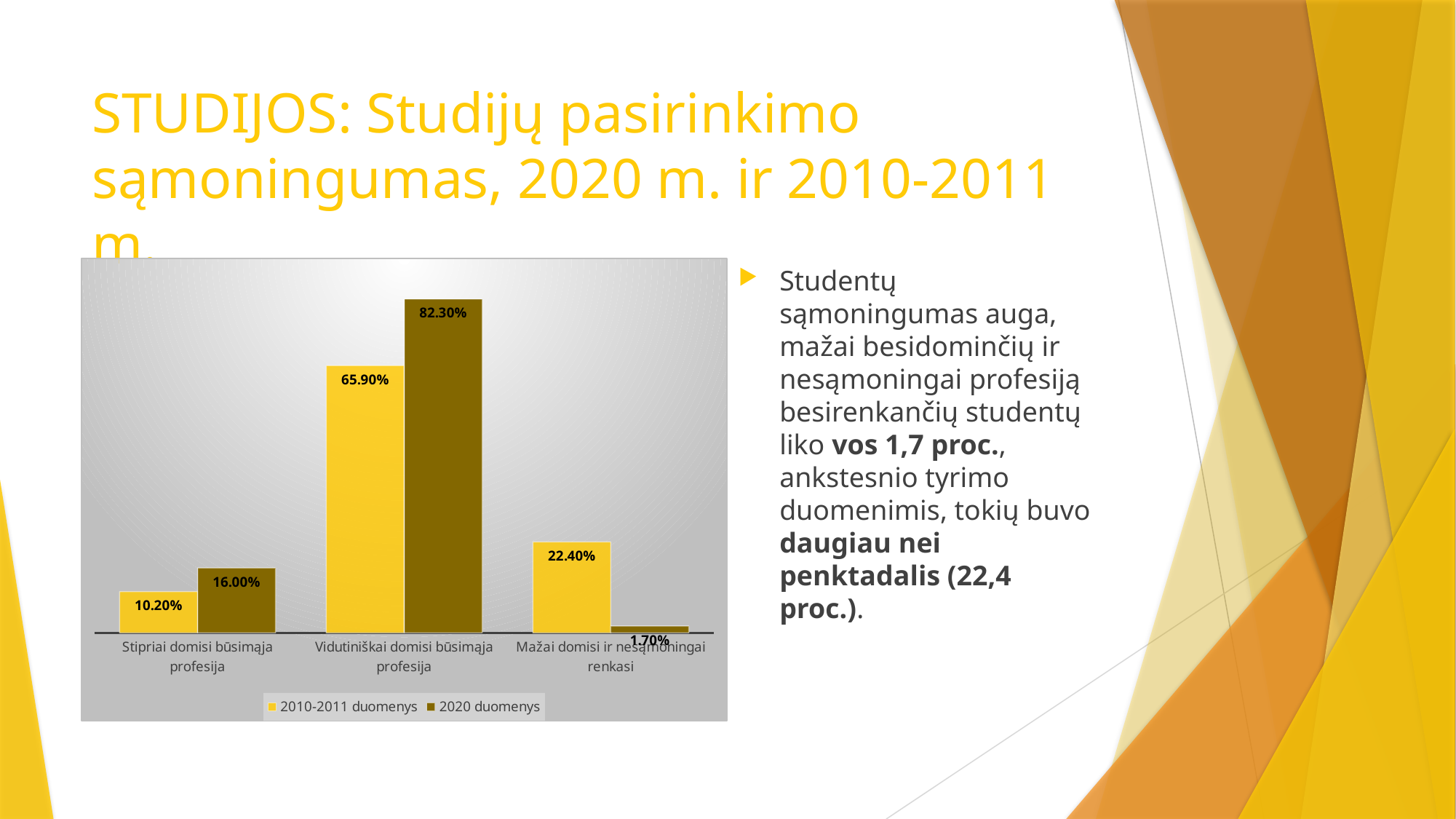
What is the value for "Stipriai domisi būsimąja profesija" in the 2010-2011 duomenys series? 10.20% What is the difference between the 2020 duomenys and 2010-2011 duomenys values for "Vidutiniškai domisi būsimąja profesija"? 16.40% Which category has the highest value in the 2020 duomenys series? Vidutiniškai domisi būsimąja profesija Which category has the lowest value in the 2020 duomenys series? Mažai domisi ir nesąmoningai renkasi What is the value for "Stipriai domisi būsimąja profesija" in the 2020 duomenys series? 16.00% Which series is shown in the darker brown colour in the chart? 2020 duomenys What kind of chart is shown on the slide? bar chart For "Mažai domisi ir nesąmoningai renkasi", which series has the larger value, 2010-2011 duomenys or 2020 duomenys? 2010-2011 duomenys How many series does the chart legend list? 2 What is the value for "Vidutiniškai domisi būsimąja profesija" in the 2020 duomenys series? 82.30% How many categories are shown on the x axis of the chart? 3 What is the value for "Mažai domisi ir nesąmoningai renkasi" in the 2010-2011 duomenys series? 22.40%